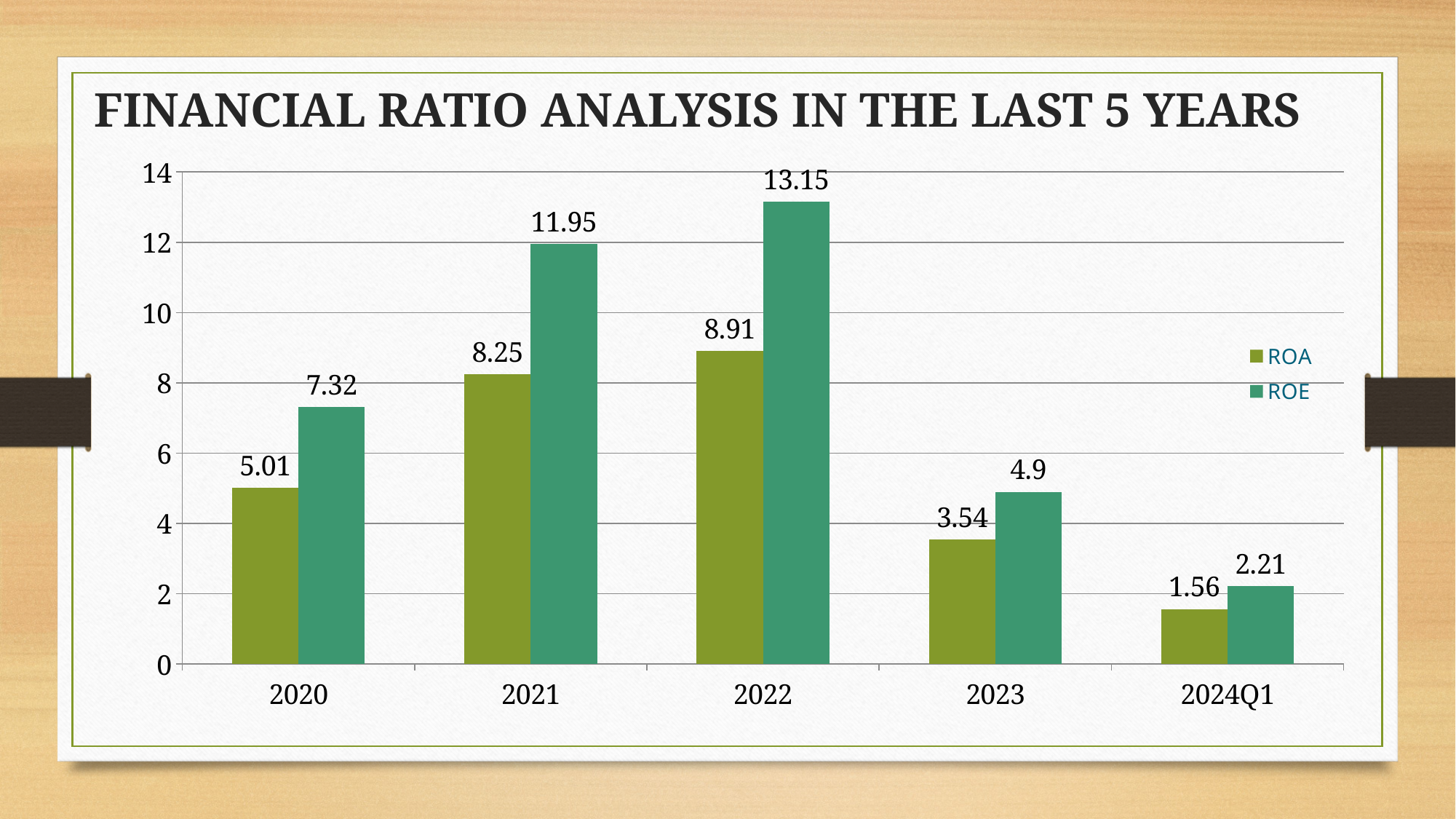
How many periods are shown on the x axis? 5 Does ROE rise or fall from 2022 to 2024Q1? Fall What kind of chart is shown on the slide? Bar chart What is the ROA value for 2024Q1? 1.56 What is the ROE value for 2023? 4.9 How many series does the legend list? 2 In which year is ROE highest? 2022 In which period is ROA lowest? 2024Q1 Which is larger in 2020, ROA or ROE? ROE What is the difference between ROE and ROA in 2022? 4.24 What is the title of the chart? FINANCIAL RATIO ANALYSIS IN THE LAST 5 YEARS What is the ROA value for 2021? 8.25